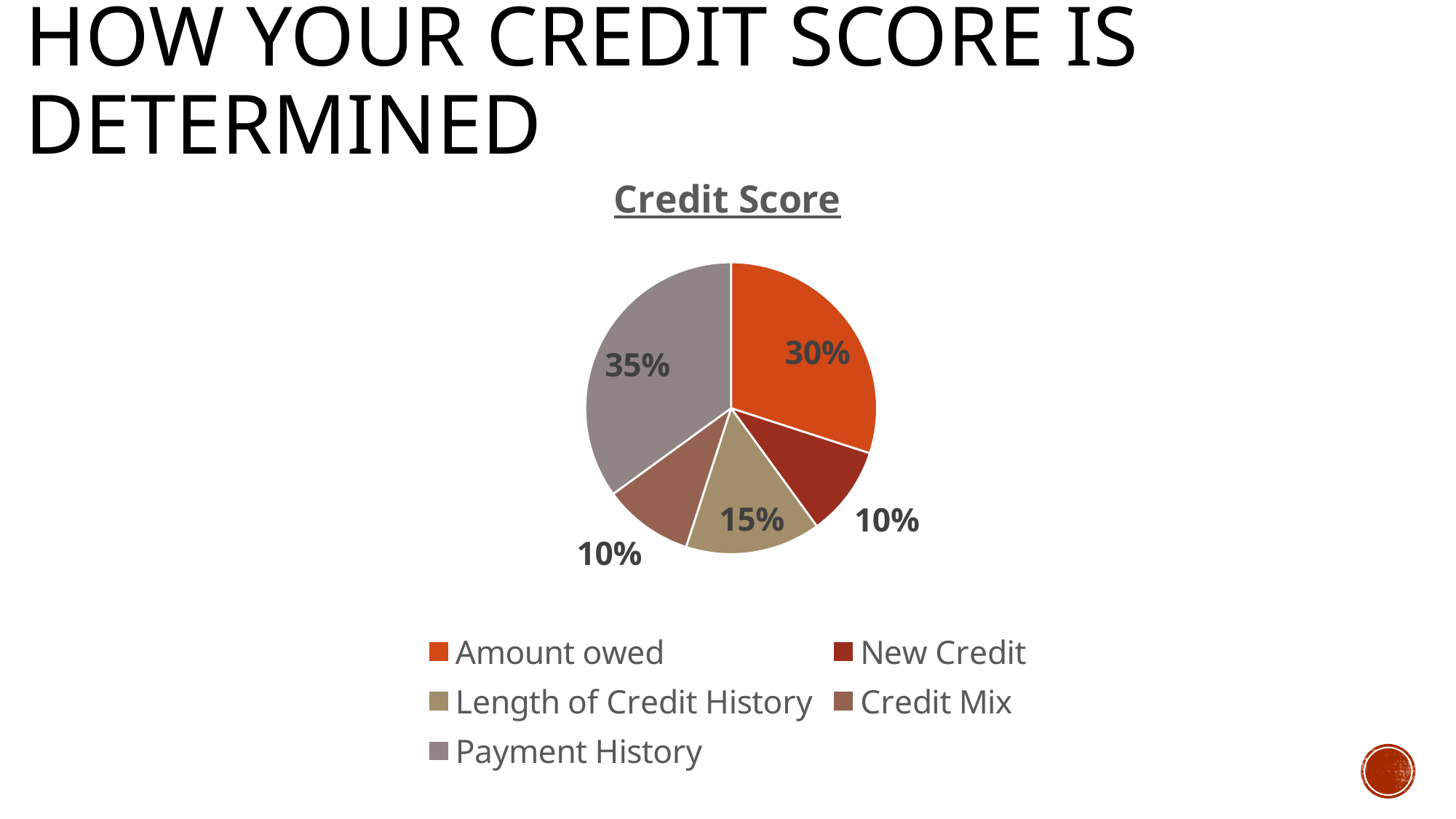
What share of the pie does Amount owed represent? 30% What colour is the Amount owed slice? orange What share of the pie does Credit Mix represent? 10% Which category has the largest slice of the pie? Payment History What is the difference between the Payment History share and the Amount owed share? 5% What is the title of the chart? Credit Score How many categories are shown in the pie chart? 5 What share of the pie does New Credit represent? 10% Which is larger, the share for Length of Credit History or the share for New Credit? Length of Credit History What type of chart is shown on the slide? pie chart